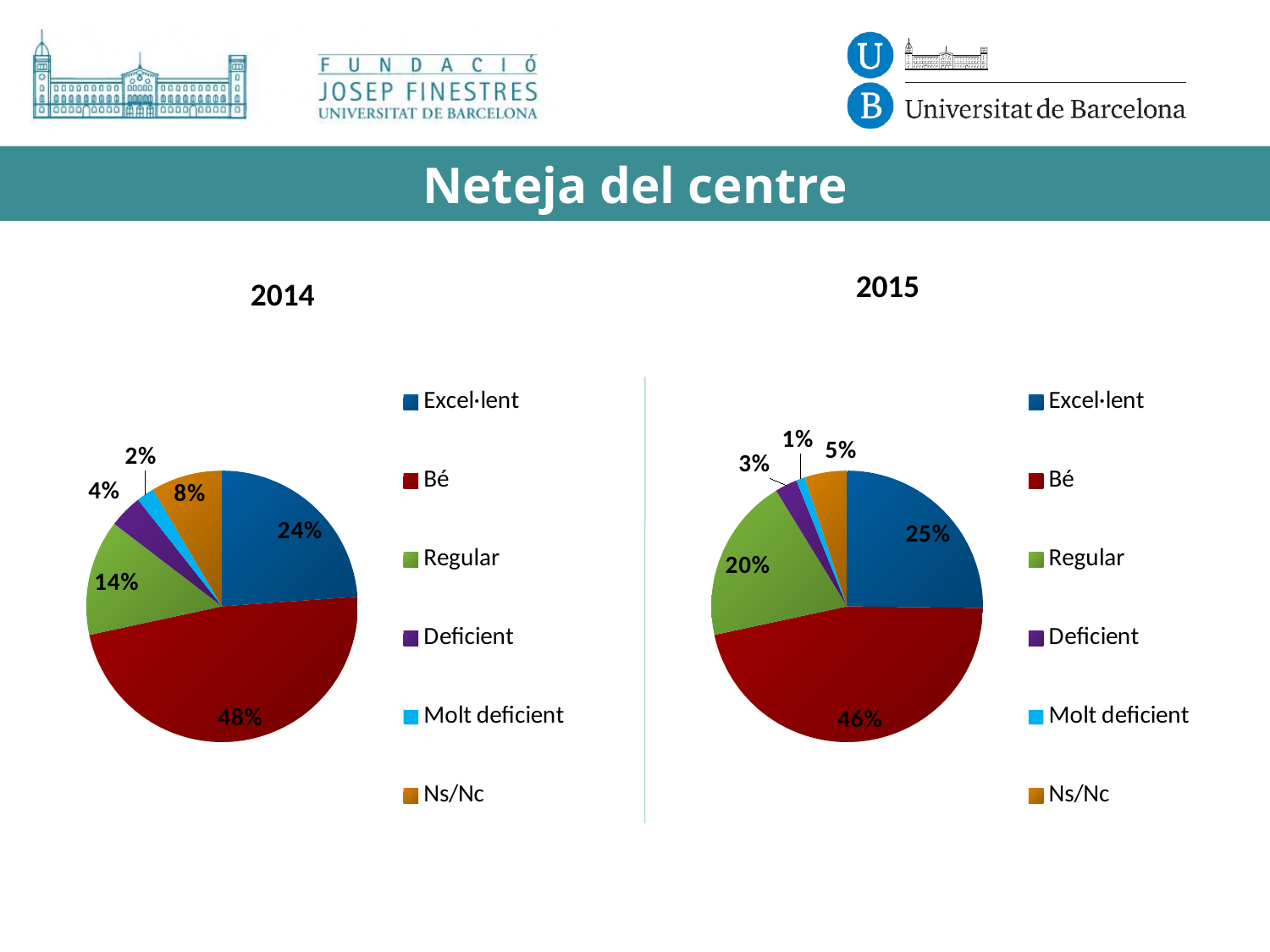
How many categories does the legend of the 2014 chart list? 6 Which is larger: Regular in the 2014 chart or Regular in the 2015 chart? Regular in the 2015 chart In the 2014 chart, what percentage is shown for Ns/Nc? 8% What kind of chart is the 2015 chart? Pie chart In the 2014 chart, what percentage is shown for Bé? 48% In the 2014 chart, what is the difference between the Bé and Excel·lent percentages? 24% What is the title shown in the banner above the two charts? Neteja del centre In the 2015 chart, what is the difference between the Regular and Ns/Nc percentages? 15% In the 2014 chart, which category has the smallest slice? Molt deficient In the 2015 chart, which category has the largest slice? Bé In the 2015 chart, what percentage is shown for Regular? 20% In the 2015 chart, what percentage is shown for Molt deficient? 1%